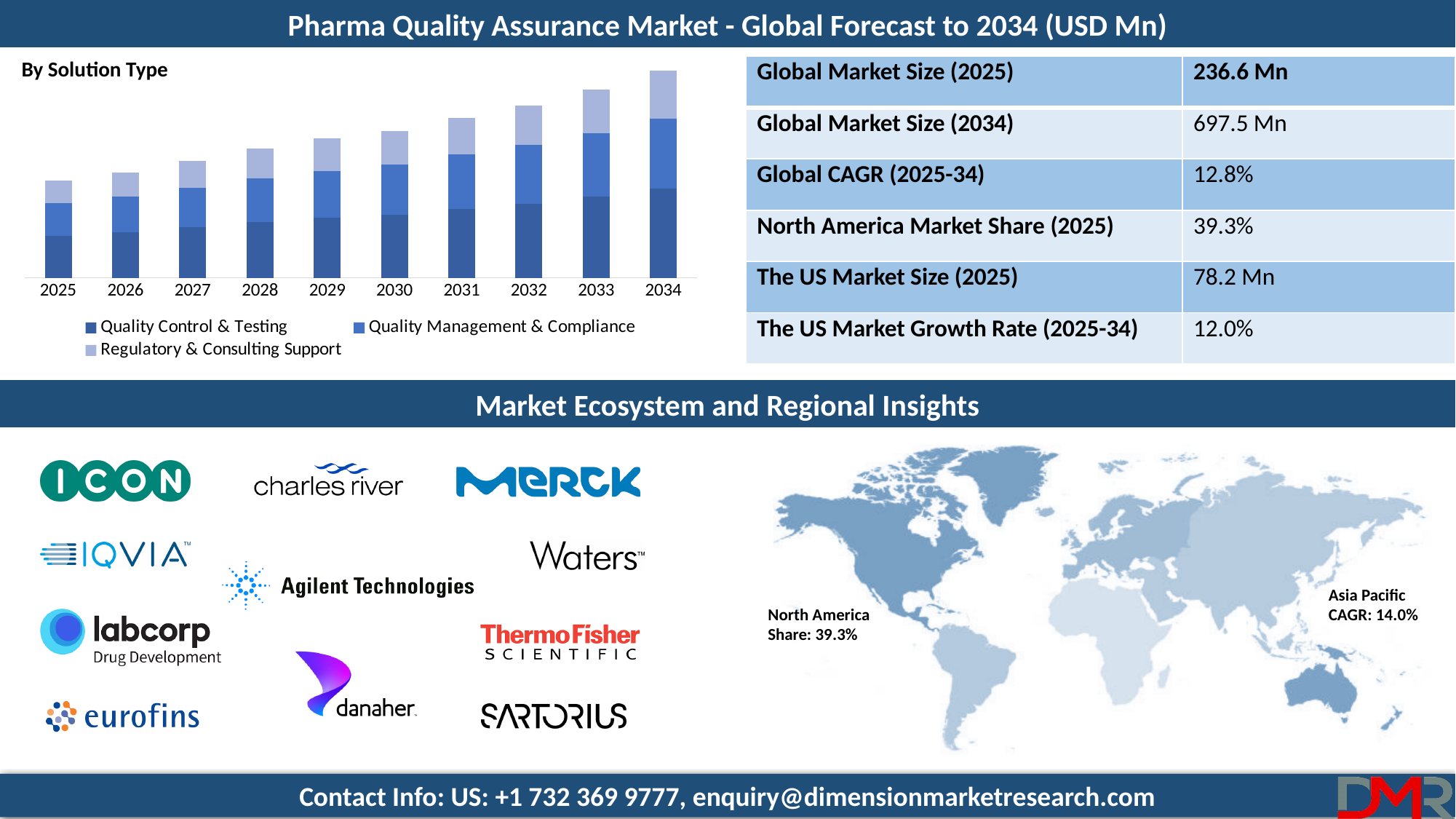
In the 'By Solution Type' chart, which bar is taller, 2030 or 2033? 2033 What kind of chart is shown under 'By Solution Type'? Stacked bar chart How many years are shown on the x axis of the 'By Solution Type' chart? 10 Which year has the tallest stacked bar in the 'By Solution Type' chart? 2034 Which year has the shortest stacked bar in the 'By Solution Type' chart? 2025 What are the three legend entries of the 'By Solution Type' chart? Quality Control & Testing, Quality Management & Compliance, Regulatory & Consulting Support What is the first year shown on the x axis of the 'By Solution Type' chart? 2025 In the 'By Solution Type' chart, which bar is taller, 2025 or 2029? 2029 How many series does the legend of the 'By Solution Type' chart list? 3 Do the stacked bars in the 'By Solution Type' chart rise or fall from 2025 to 2034? Rise In the 'By Solution Type' chart, which series forms the smallest segment of the 2034 bar? Regulatory & Consulting Support Which series is shown at the bottom of each stacked bar in the 'By Solution Type' chart? Quality Control & Testing